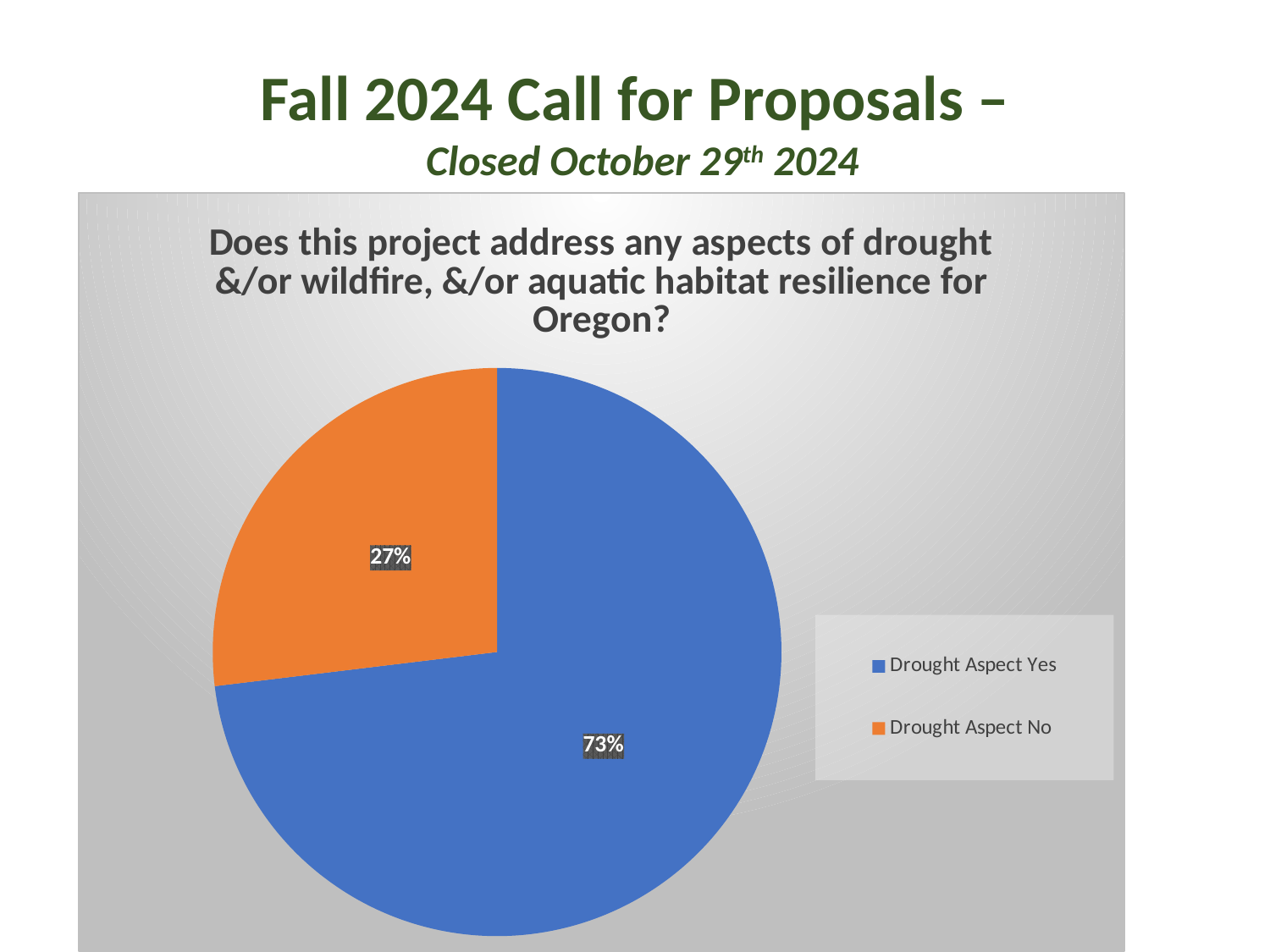
What colour is the Drought Aspect Yes slice? blue How many entries does the legend list? 2 What is the difference in percentage points between the Drought Aspect Yes and Drought Aspect No slices? 46 Which slice of the pie is the largest? Drought Aspect Yes Which is larger, the Drought Aspect Yes slice or the Drought Aspect No slice? Drought Aspect Yes How many slices does the pie chart have? 2 What percentage of the pie is labelled Drought Aspect Yes? 73% What percentage of the pie is labelled Drought Aspect No? 27% What kind of chart is shown on the slide? pie chart What is the title of the pie chart? Does this project address any aspects of drought &/or wildfire, &/or aquatic habitat resilience for Oregon? Which slice of the pie is the smallest? Drought Aspect No What share of the pie does the Drought Aspect No slice represent? 27%